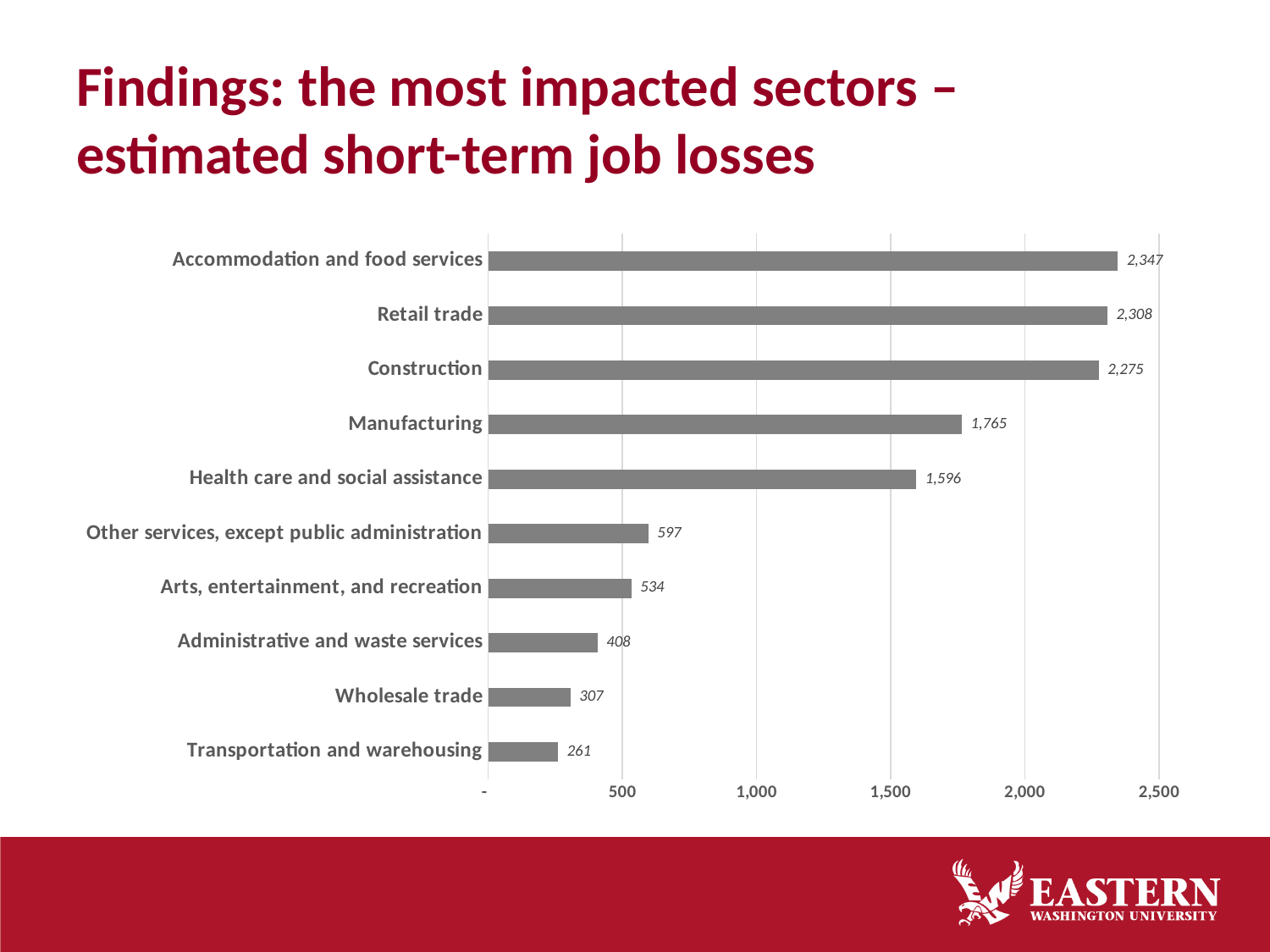
What is the difference between the values for Accommodation and food services and Retail trade? 39 What is the value shown for Health care and social assistance? 1,596 Which has a larger value, Construction or Manufacturing? Construction What is the estimated short-term job loss for Manufacturing? 1,765 What is the value shown for Wholesale trade? 307 Is the value for Administrative and waste services greater or less than 500? less Which sector has the lowest estimated short-term job losses? Transportation and warehousing How many sectors are shown in the chart? 10 What kind of chart is shown on the slide? Bar chart What is the difference between the values for Other services, except public administration and Arts, entertainment, and recreation? 63 What is the highest value labelled on the horizontal axis? 2,500 Which sector has the highest estimated short-term job losses? Accommodation and food services